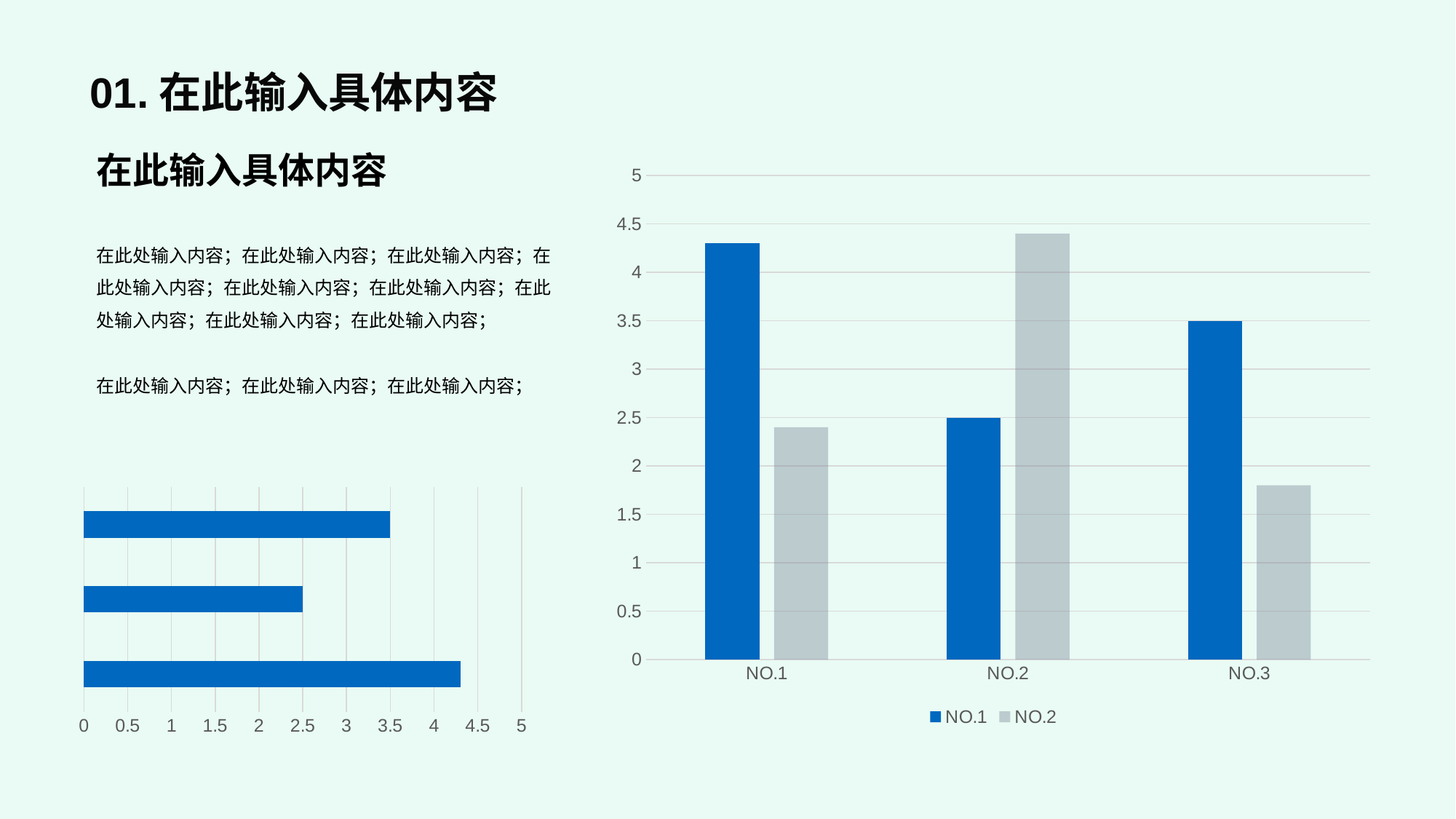
In the right-hand chart, is the value of the NO.2 series for category NO.2 greater or less than 4? greater In the bottom-left chart, what is the value of the top bar? 3.5 How many series does the legend of the right-hand chart list? 2 In the right-hand chart, which category has the highest value for the NO.1 series? NO.1 How many categories are shown on the x axis of the right-hand chart? 3 In the right-hand chart, what is the value of the NO.1 series for category NO.3? 3.5 In the right-hand chart, for category NO.1, which series has the larger value, NO.1 or NO.2? NO.1 What kind of chart is the chart on the right of the slide? bar chart In the right-hand chart, which category has the lowest value for the NO.2 series? NO.3 In the right-hand chart, what is the value of the NO.1 series for category NO.2? 2.5 In the right-hand chart, what is the difference between the NO.1 series values for categories NO.3 and NO.2? 1 What kind of chart is the chart at the bottom left of the slide? bar chart